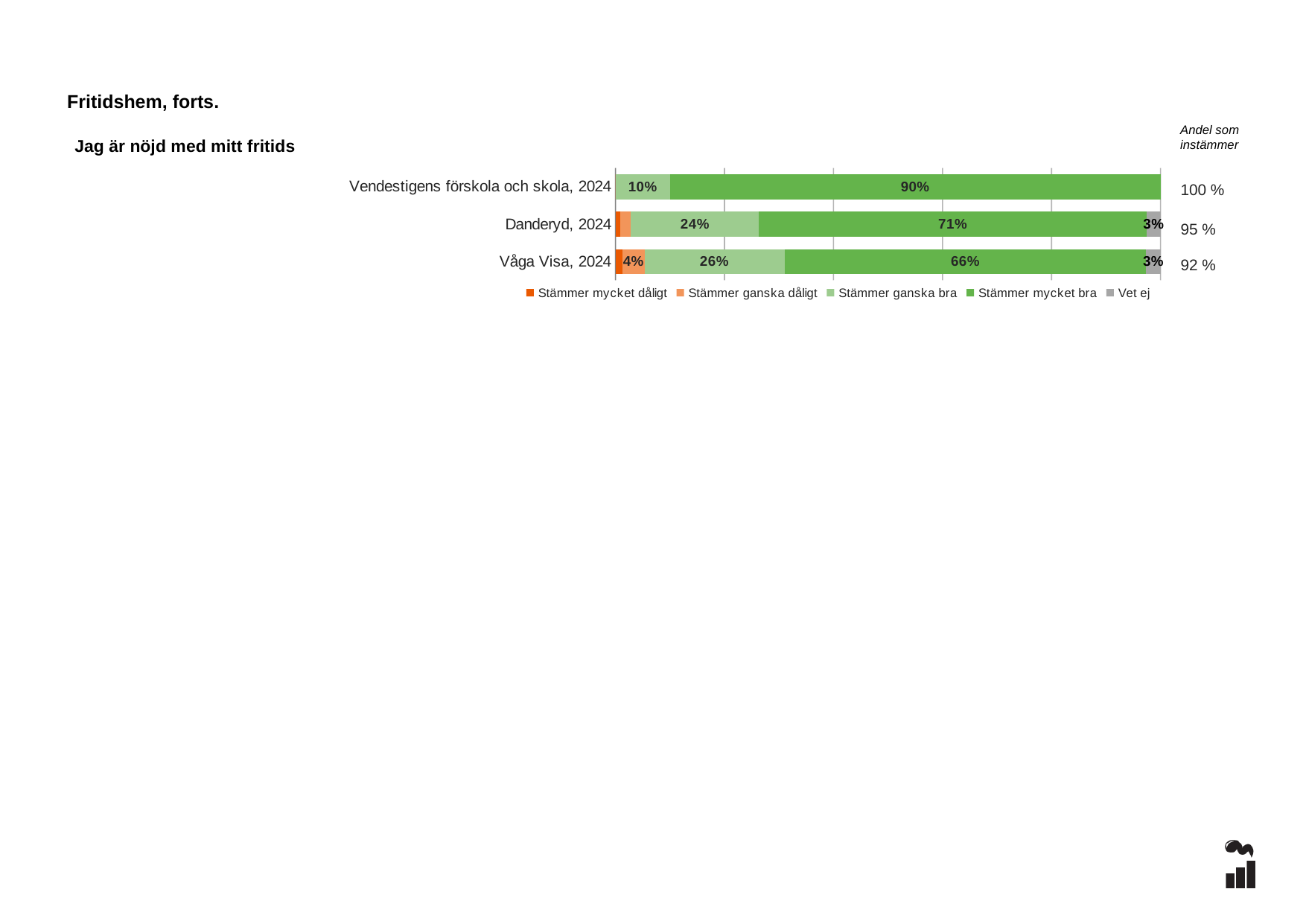
What is the 'Vet ej' value for Danderyd, 2024? 3% Which category has the highest 'Stämmer mycket bra' value? Vendestigens förskola och skola, 2024 What is the difference between the 'Stämmer mycket bra' values for Danderyd, 2024 and Våga Visa, 2024? 5% What kind of chart is shown on the slide? stacked bar chart What is the 'Stämmer mycket bra' value for Våga Visa, 2024? 66% How many categories (rows) does the chart show? 3 What is the 'Andel som instämmer' value shown for Våga Visa, 2024? 92 % What is the 'Stämmer ganska bra' value for Danderyd, 2024? 24% Which is larger: the 'Stämmer ganska bra' value for Våga Visa, 2024 or for Danderyd, 2024? Våga Visa, 2024 What is the 'Stämmer mycket bra' value for Vendestigens förskola och skola, 2024? 90% Which category has the lowest 'Stämmer ganska bra' value? Vendestigens förskola och skola, 2024 How many series does the legend list? 5